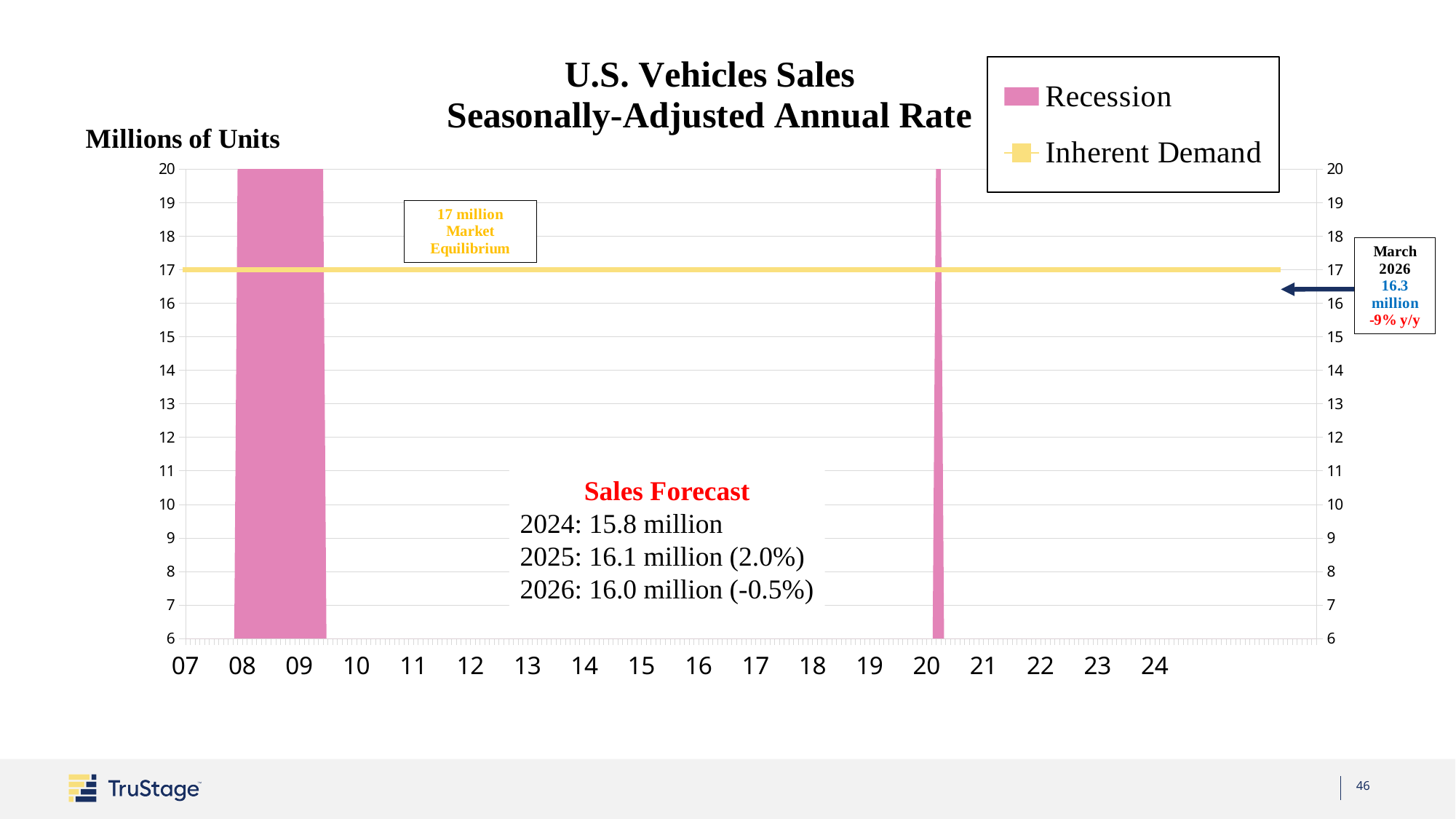
What is the sales forecast for 2024 shown on the chart? 15.8 million How many series does the chart legend list? 2 What is the title of the chart? U.S. Vehicles Sales Seasonally-Adjusted Annual Rate What is the March 2026 value shown in the annotation on the right of the chart? 16.3 million What is the unit of the vertical axis on the chart? Millions of Units At what level does the Inherent Demand line sit, according to the annotation on the chart? 17 million What is the sales forecast for 2026 shown on the chart? 16.0 million What are the two entries in the chart legend? Recession and Inherent Demand How many shaded recession periods are shown on the chart? 2 What is the sales forecast for 2025 shown on the chart? 16.1 million By how much does the 2025 sales forecast exceed the 2024 sales forecast? 0.3 million What year-over-year change is shown for March 2026? -9% y/y